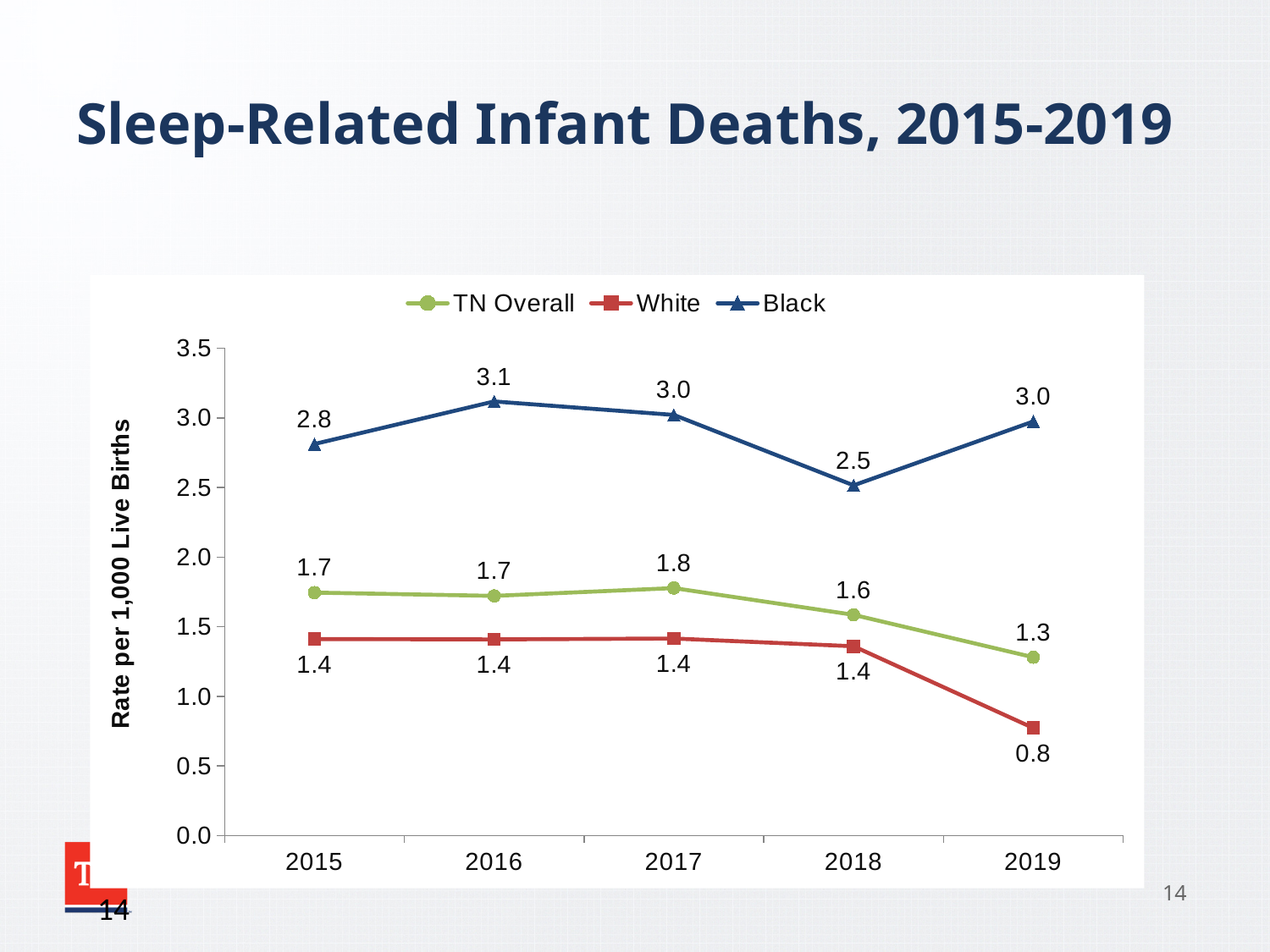
Which is larger in 2018, the Black rate or the TN Overall rate? Black In which year is the Black rate lowest? 2018 What is the difference between the Black rate and the White rate in 2019? 2.2 How many years are shown on the x axis? 5 Does the White rate rise or fall from 2018 to 2019? fall What is the Black rate in 2016? 3.1 What is the White rate in 2019? 0.8 What is the TN Overall rate in 2017? 1.8 What kind of chart is shown? line chart How many series does the legend list? 3 In which year is the TN Overall rate highest? 2017 What is the y-axis label of the chart? Rate per 1,000 Live Births